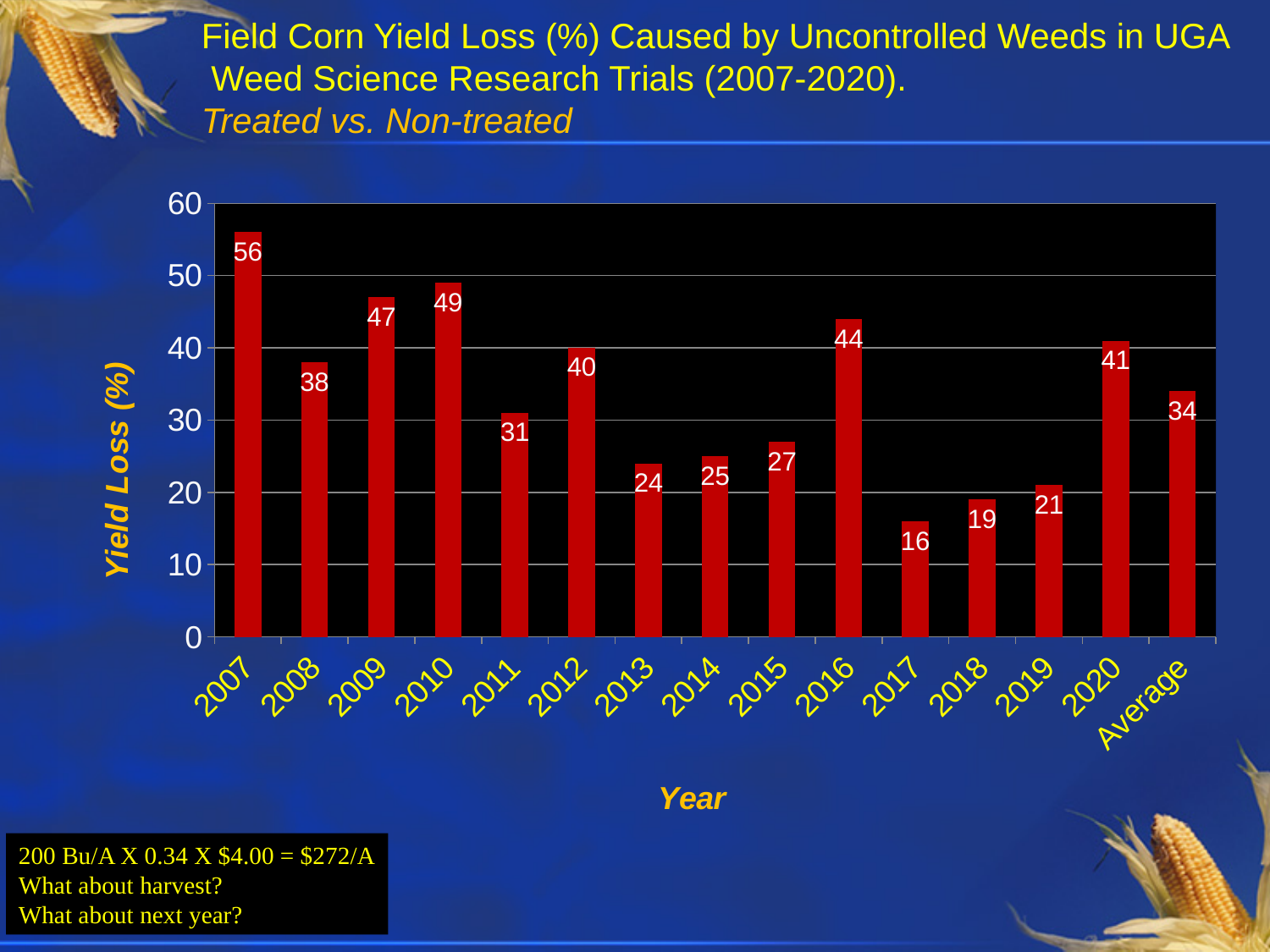
What colour are the bars in the chart? Red What is the label of the y axis? Yield Loss (%) Is the value for 2012 greater or less than 30? greater Which year has a larger yield loss, 2016 or 2020? 2016 What is the difference between the yield loss in 2010 and in 2011? 18 What kind of chart is shown on the slide? Bar chart What is the yield loss value for 2017? 16 What is the yield loss value for 2007? 56 Which year has the highest yield loss? 2007 How many bars are plotted in the chart? 15 Which year has the lowest yield loss? 2017 What is the value shown for the Average bar? 34